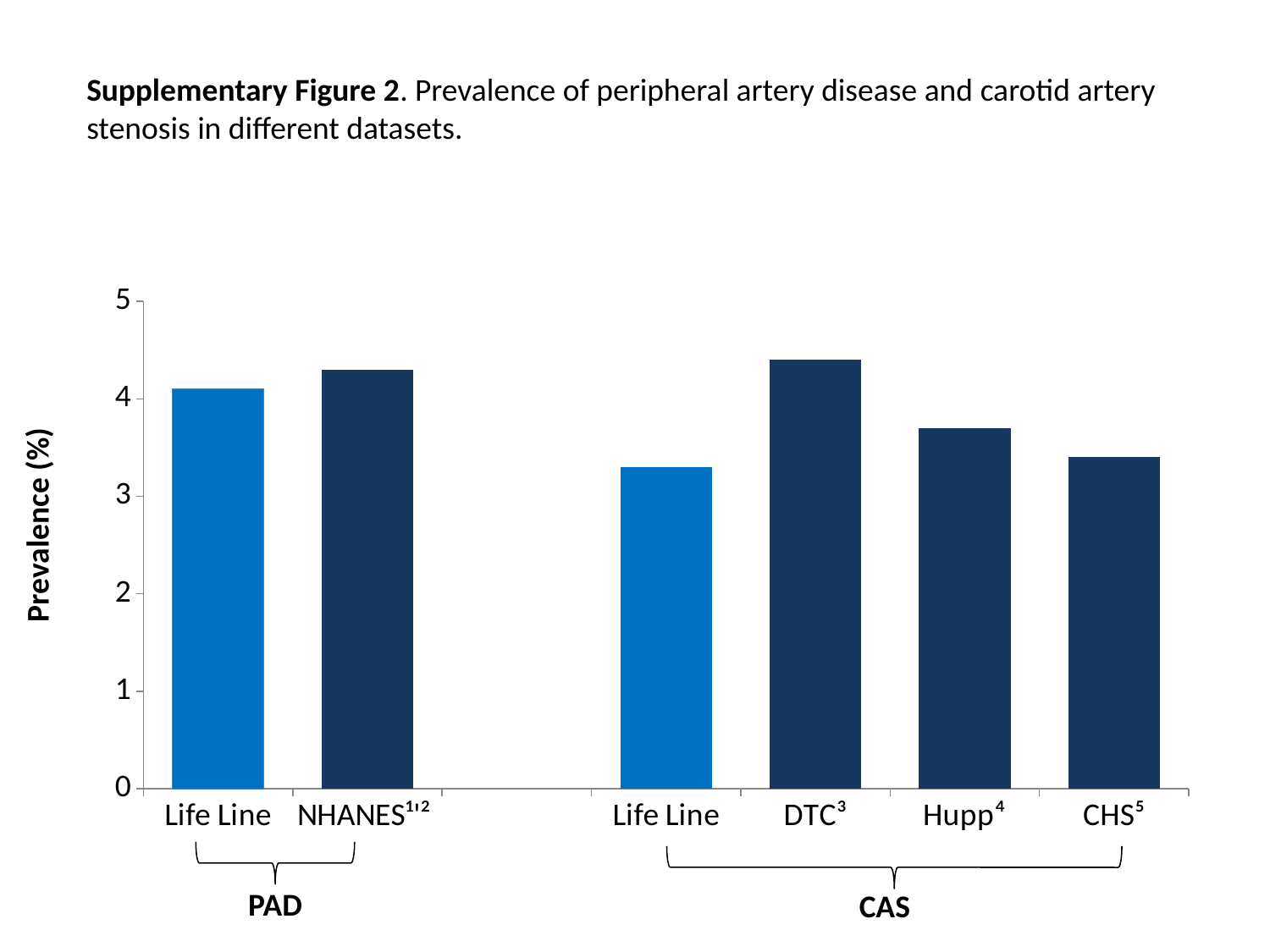
How many bars are plotted in the chart? 6 Is the value for DTC greater or less than 4? greater Is the value for NHANES greater or less than 4? greater What is the label of the vertical axis? Prevalence (%) Is the value for Hupp greater or less than 3? greater Which is larger, the value for Life Line in the CAS group or the value for DTC? DTC Which is larger, the value for DTC or the value for Hupp? DTC How many datasets are grouped under CAS? 4 What kind of chart is shown on the slide? bar chart